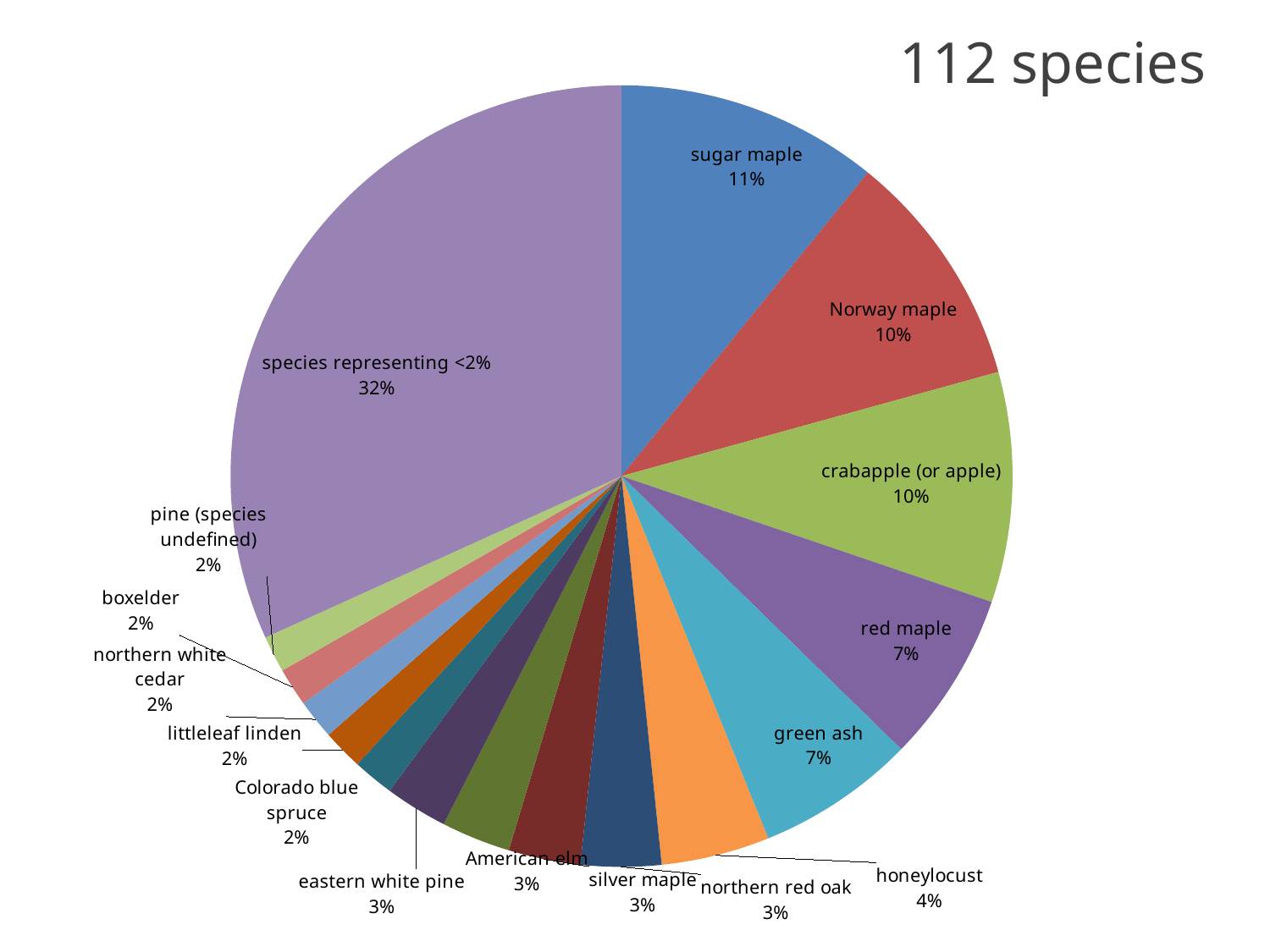
Which slice is the largest in the pie chart? species representing <2% What is the title of the chart? 112 species Which is larger, the share for green ash or the share for honeylocust? green ash What percentage is shown for red maple? 7% What percentage is shown for eastern white pine? 3% How many slices does the pie chart have? 16 What percentage is shown for Norway maple? 10% What percentage is shown for honeylocust? 4% What is the difference in percentage points between the 'species representing <2%' slice and sugar maple? 21 What type of chart is shown on the slide? pie chart What is the difference in percentage points between sugar maple and red maple? 4 What share of the pie does sugar maple represent? 11%